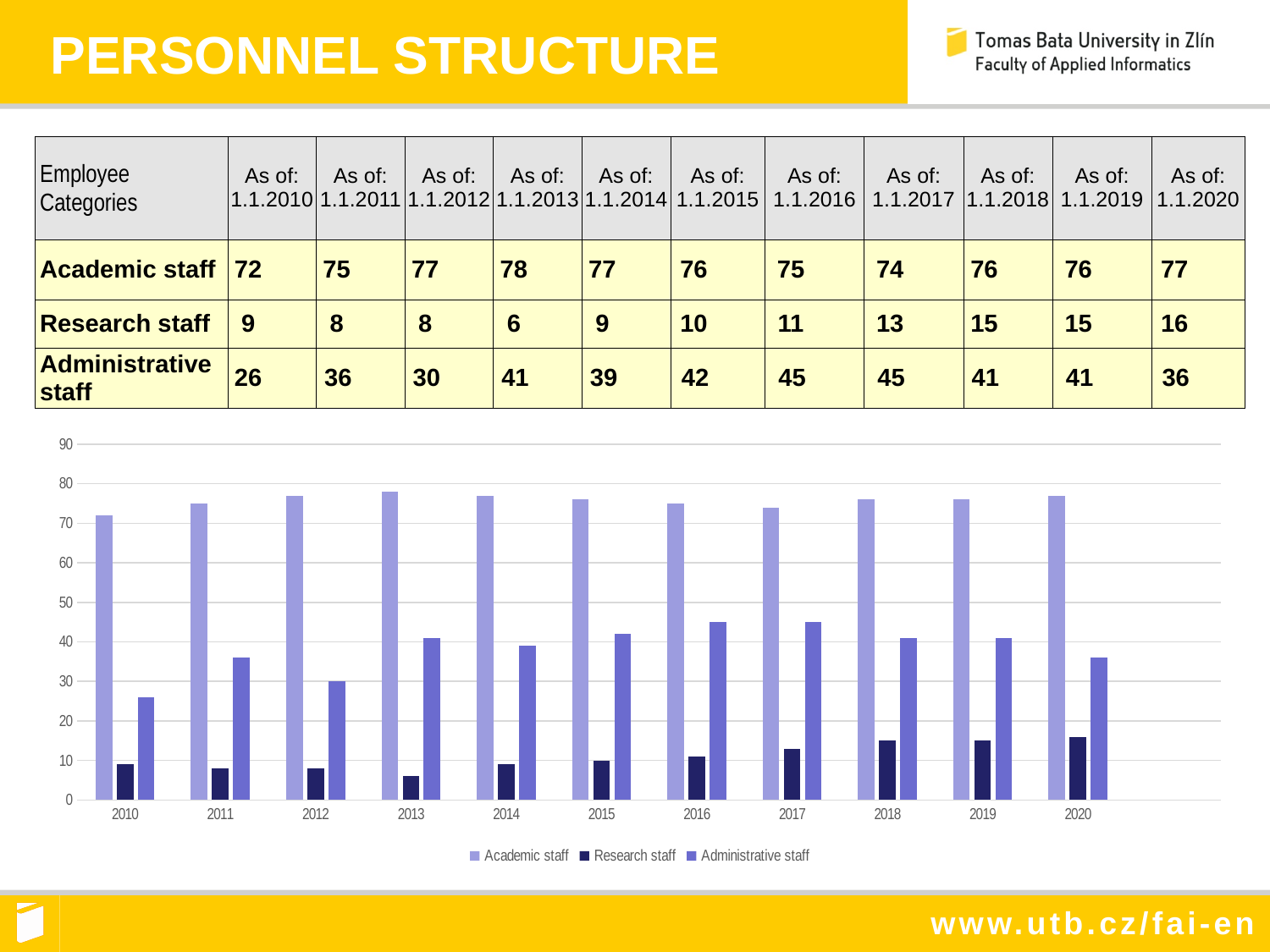
Which is larger in 2012: Administrative staff or Research staff? Administrative staff Is the value for Academic staff in 2010 greater or less than 80? less What is the value for Research staff in 2020? 16 In which year is the Academic staff value highest? 2013 Does the Research staff value rise or fall from 2013 to 2020? rise What is the value for Academic staff in 2013? 78 How many series does the chart legend list? 3 What is the difference between Administrative staff in 2016 and in 2010? 19 What is the value for Administrative staff in 2010? 26 In which year is the Research staff value lowest? 2013 How many years are shown along the x axis of the chart? 11 What kind of chart is shown on the slide? bar chart